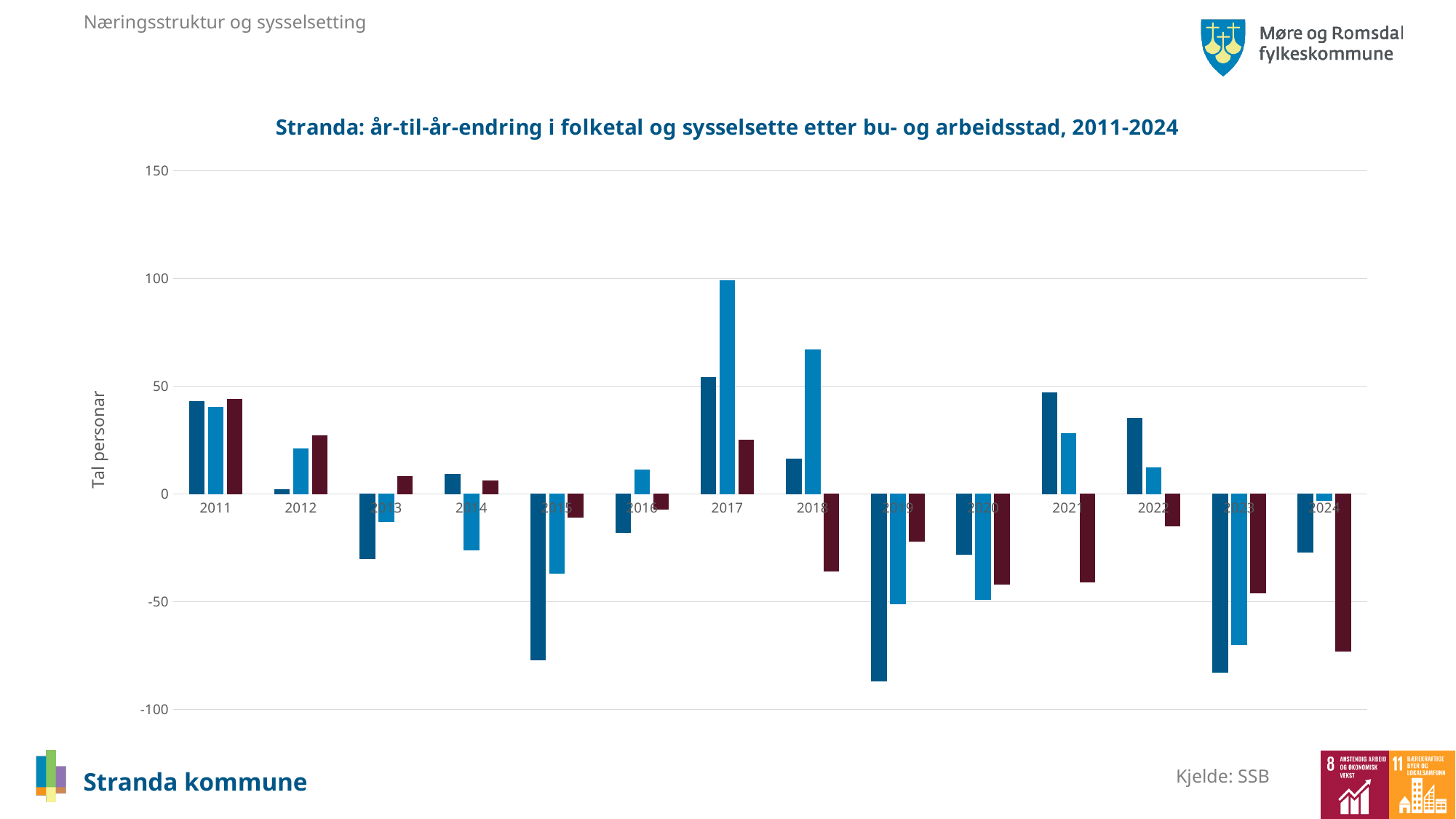
Is the value of the dark blue bar for 2019 greater or less than -50? less Is the value of the dark red bar for 2024 greater or less than -50? less Which is larger, the light blue bar for 2017 or the light blue bar for 2018? 2017 How many years are shown along the x axis of the chart? 14 What is the title of the chart? Stranda: år-til-år-endring i folketal og sysselsette etter bu- og arbeidsstad, 2011-2024 How many bars are plotted for each year in the chart? 3 What is the label on the vertical axis of the chart? Tal personar In which year is the light blue bar highest? 2017 In which year is the dark red bar lowest? 2024 What type of chart is shown on the slide? Bar chart Is the value of the light blue bar for 2017 greater or less than 50? greater